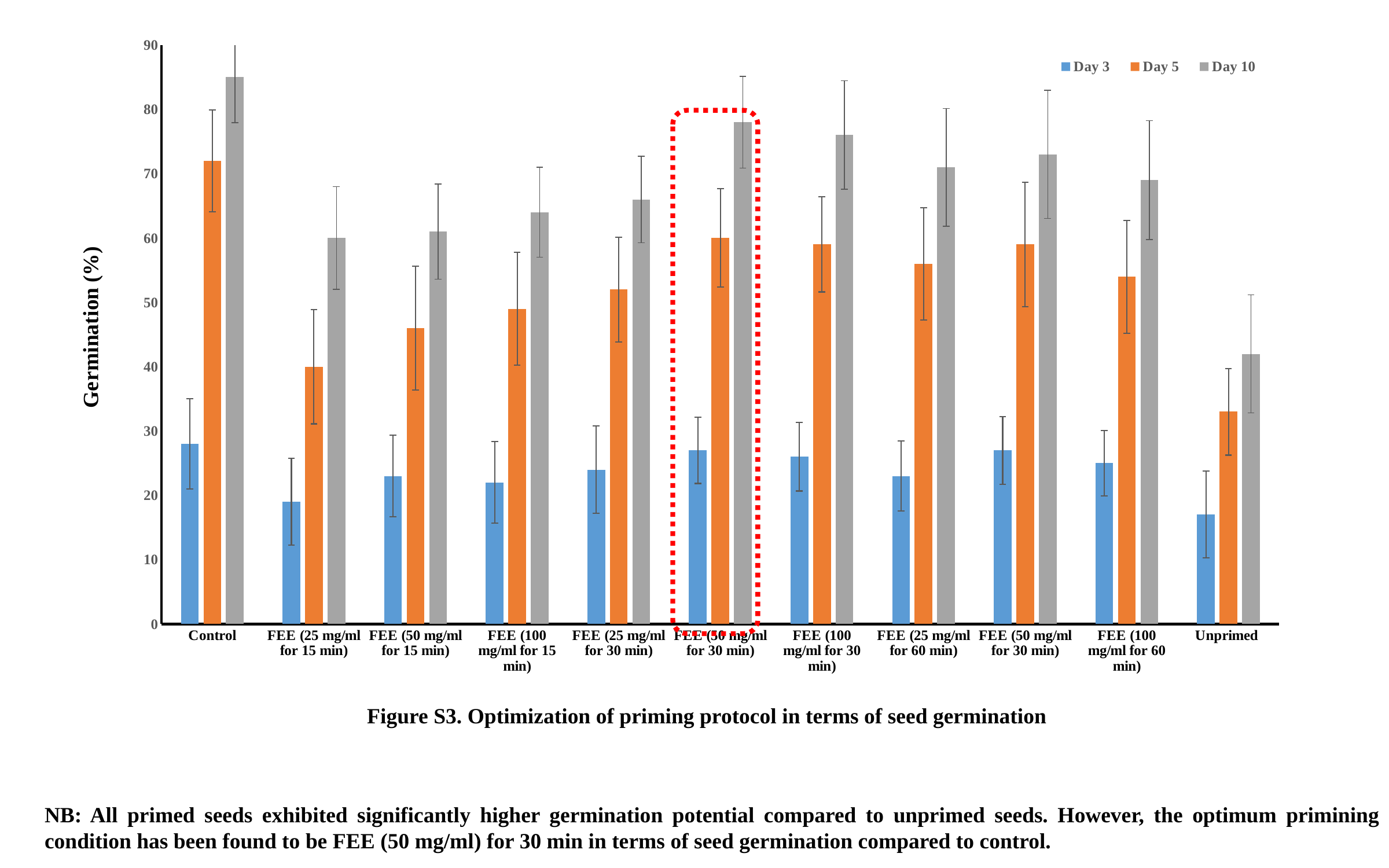
Is the Day 10 value for Unprimed greater or less than 50? less Which category has the highest Day 10 germination value? Control Which category has the lowest Day 10 germination value? Unprimed What kind of chart is shown on the slide? bar chart Is the Day 3 value for Unprimed greater or less than 20? less How many categories are shown along the x axis? 11 Which is larger: the Day 5 value for FEE (25 mg/ml for 15 min) or the Day 5 value for FEE (100 mg/ml for 30 min)? FEE (100 mg/ml for 30 min) Is the Day 10 value for FEE (100 mg/ml for 30 min) greater or less than 70? greater How many series does the legend list? 3 Which category has the lowest Day 5 germination value? Unprimed What is the label of the y axis? Germination (%)